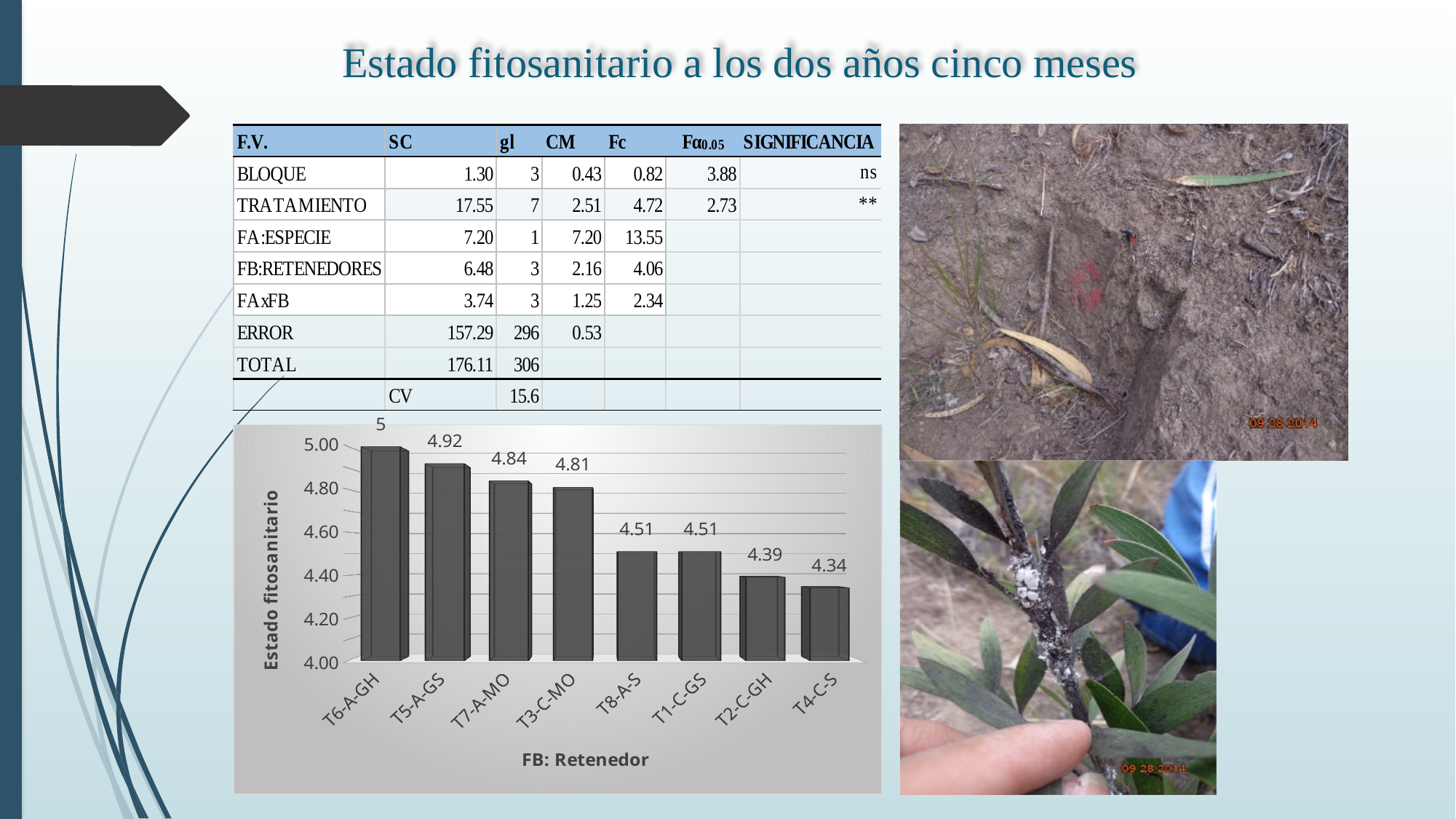
How many categories are shown on the x axis? 8 What is the value for T5-A-GS? 4.92 What is the difference between the values for T6-A-GH and T4-C-S? 0.66 Which category has the lowest value? T4-C-S What is the label of the vertical axis? Estado fitosanitario What kind of chart is this? bar chart Do the values rise or fall from left to right along the x axis? fall What is the difference between the values for T3-C-MO and T8-A-S? 0.30 Which category has the highest value? T6-A-GH Which is larger, the value for T7-A-MO or the value for T1-C-GS? T7-A-MO What is the value for T7-A-MO? 4.84 What is the value for T2-C-GH? 4.39